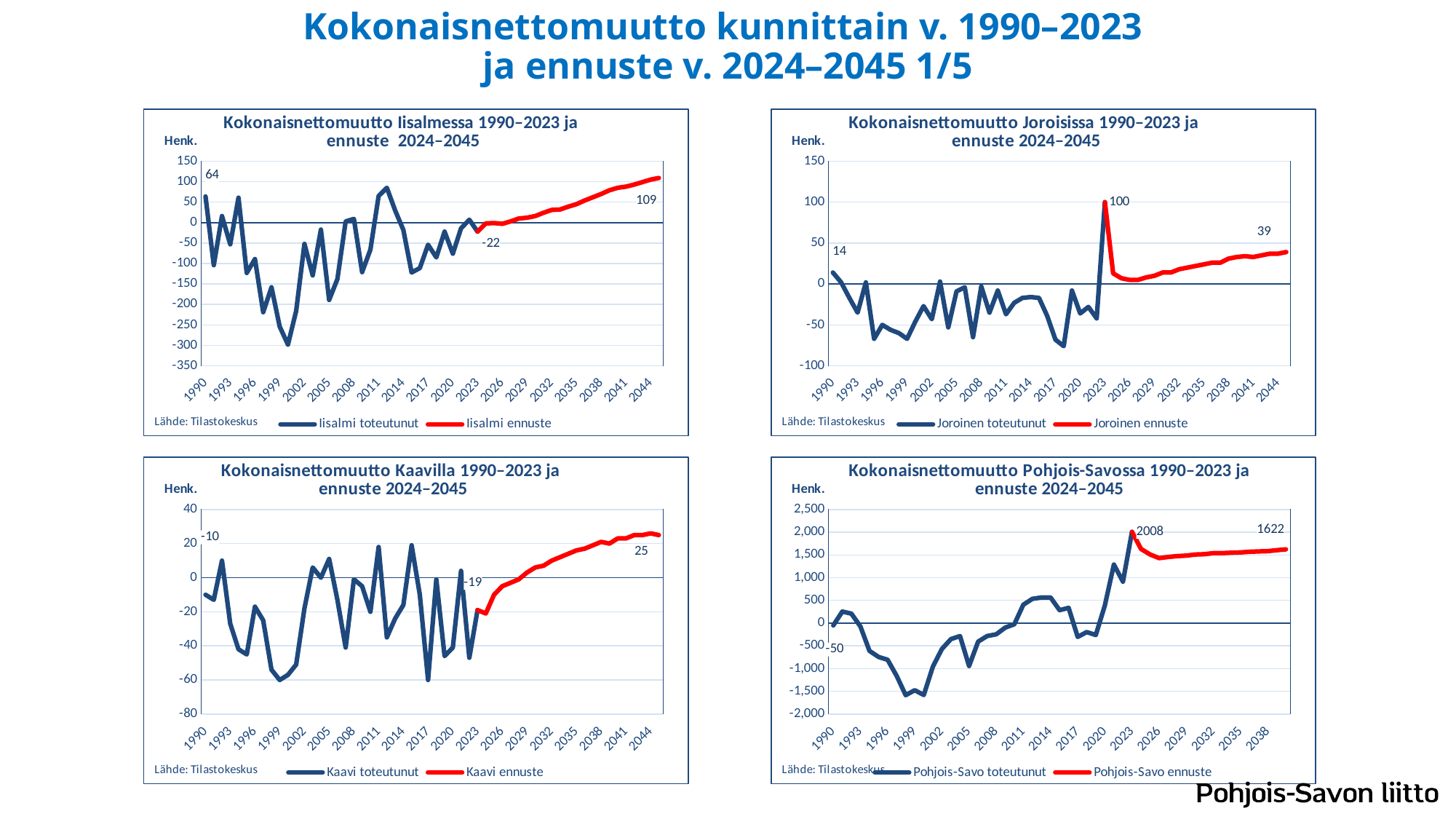
In the Kokonaisnettomuutto Pohjois-Savossa chart, is the value around 1999 greater or less than -1,000? less How many series does the legend of the Kokonaisnettomuutto Kaavilla chart list? 2 In the Kokonaisnettomuutto Pohjois-Savossa chart, what is the difference between the labelled 2023 value and the labelled value at the end of the forecast line? 386 What kind of chart is the Kokonaisnettomuutto Iisalmessa chart? line chart In the Kokonaisnettomuutto Joroisissa chart, what is the labelled value for 2023? 100 In the Kokonaisnettomuutto Pohjois-Savossa chart, what is the labelled value for 2023? 2008 In the Kokonaisnettomuutto Joroisissa chart, which is larger: the labelled value for 2023 or the labelled value at the end of the forecast line? 2023 In the Kokonaisnettomuutto Kaavilla chart, what is the labelled value at the end of the forecast line? 25 In the Kokonaisnettomuutto Iisalmessa chart, what is the labelled value for 1990? 64 In the Kokonaisnettomuutto Kaavilla chart, what is the labelled value for 1990? -10 In the Kokonaisnettomuutto Iisalmessa chart, what is the labelled value at the end of the forecast (ennuste) line? 109 In the Kokonaisnettomuutto Iisalmessa chart, what is the labelled value for 2023? -22